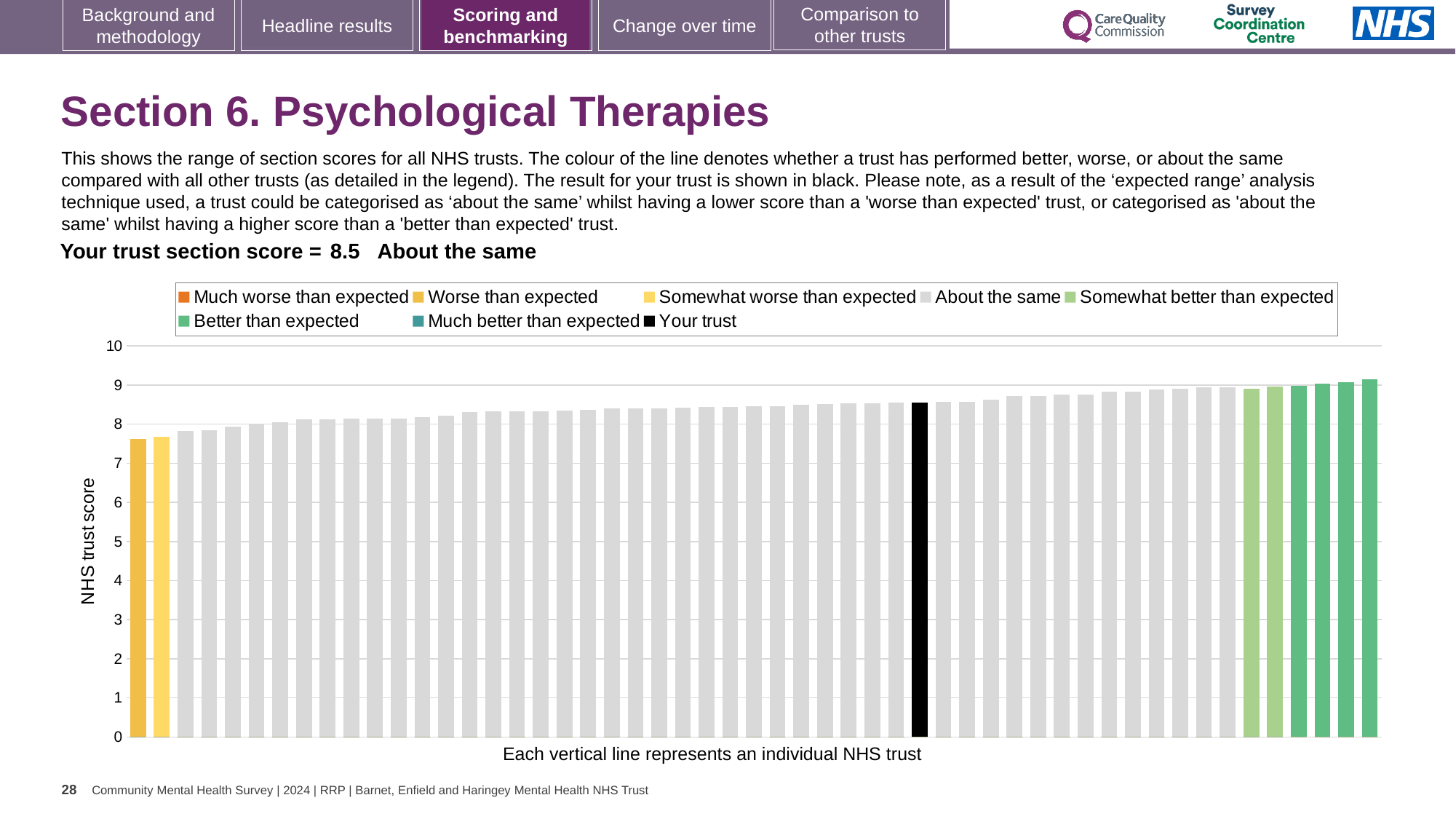
Is the highest bar on the left or the right side of the chart? right Is the value of the leftmost bar greater or less than 8? less What kind of chart is shown on the slide? bar chart What is the maximum value shown on the vertical axis? 10 Do the bar values rise or fall from left to right across the chart? rise What colour is the bar representing your trust? black Which category is your trust's section score placed in? About the same What is the label on the vertical axis of the chart? NHS trust score How many entries does the chart legend list? 8 What is the section score for your trust shown on the slide? 8.5 Is the value for your trust greater or less than 8? greater Is the value of the rightmost bar greater or less than 9? greater